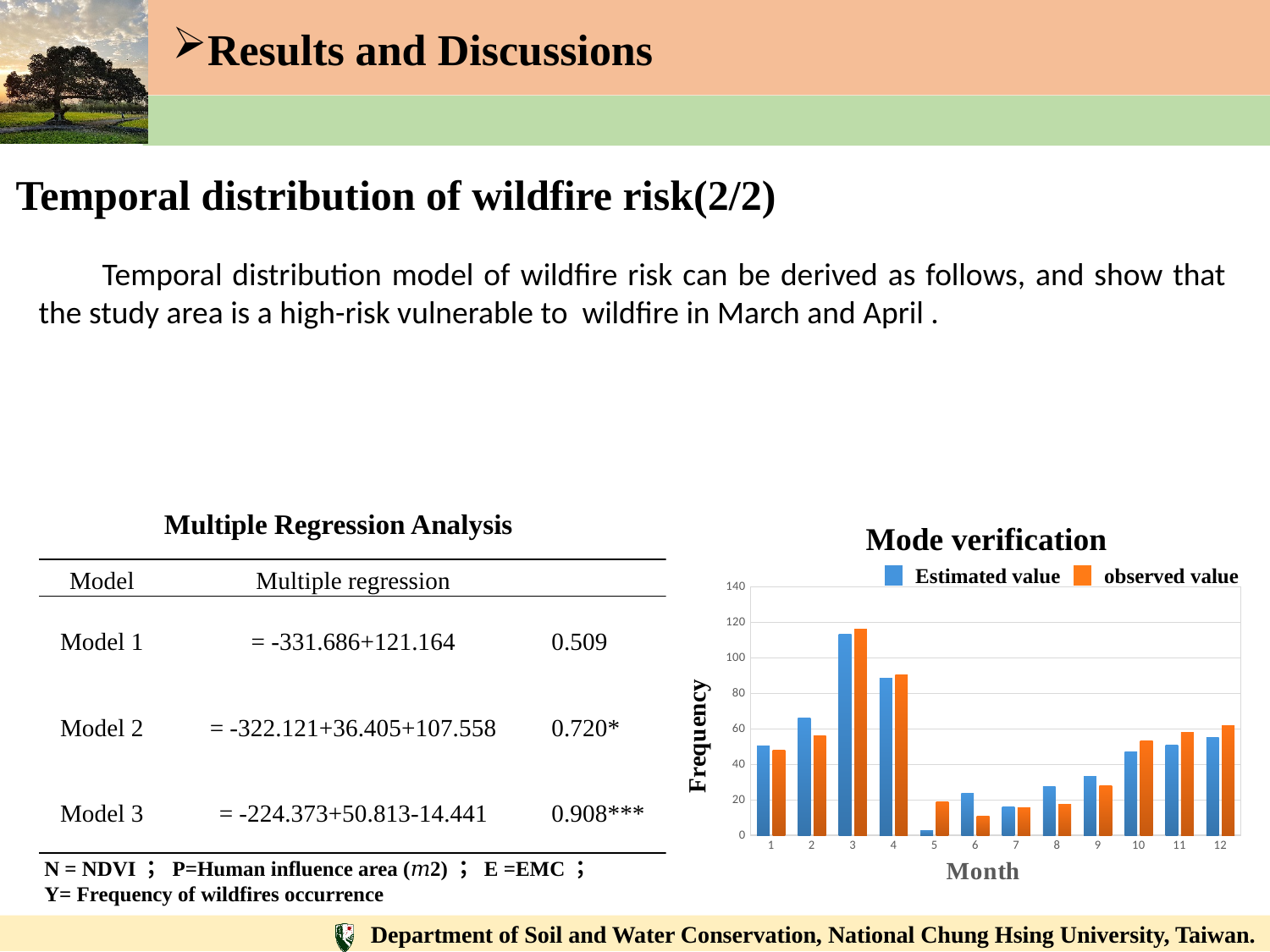
In the 'Mode verification' chart, do the observed values rise or fall from month 6 to month 12? rise How many series does the legend of the 'Mode verification' chart list? 2 In the 'Mode verification' chart, which month has the highest estimated value? 3 What kind of chart is the 'Mode verification' chart? bar chart How many months are shown on the x axis of the 'Mode verification' chart? 12 In the 'Mode verification' chart, is the estimated value for month 3 greater or less than 100? greater In the 'Mode verification' chart, which month has the lowest observed value? 6 What is the label of the y axis of the 'Mode verification' chart? Frequency In the 'Mode verification' chart, which month has the highest observed value? 3 In the 'Mode verification' chart, which month has the lowest estimated value? 5 In the 'Mode verification' chart, for month 2, which is larger: the estimated value or the observed value? Estimated value